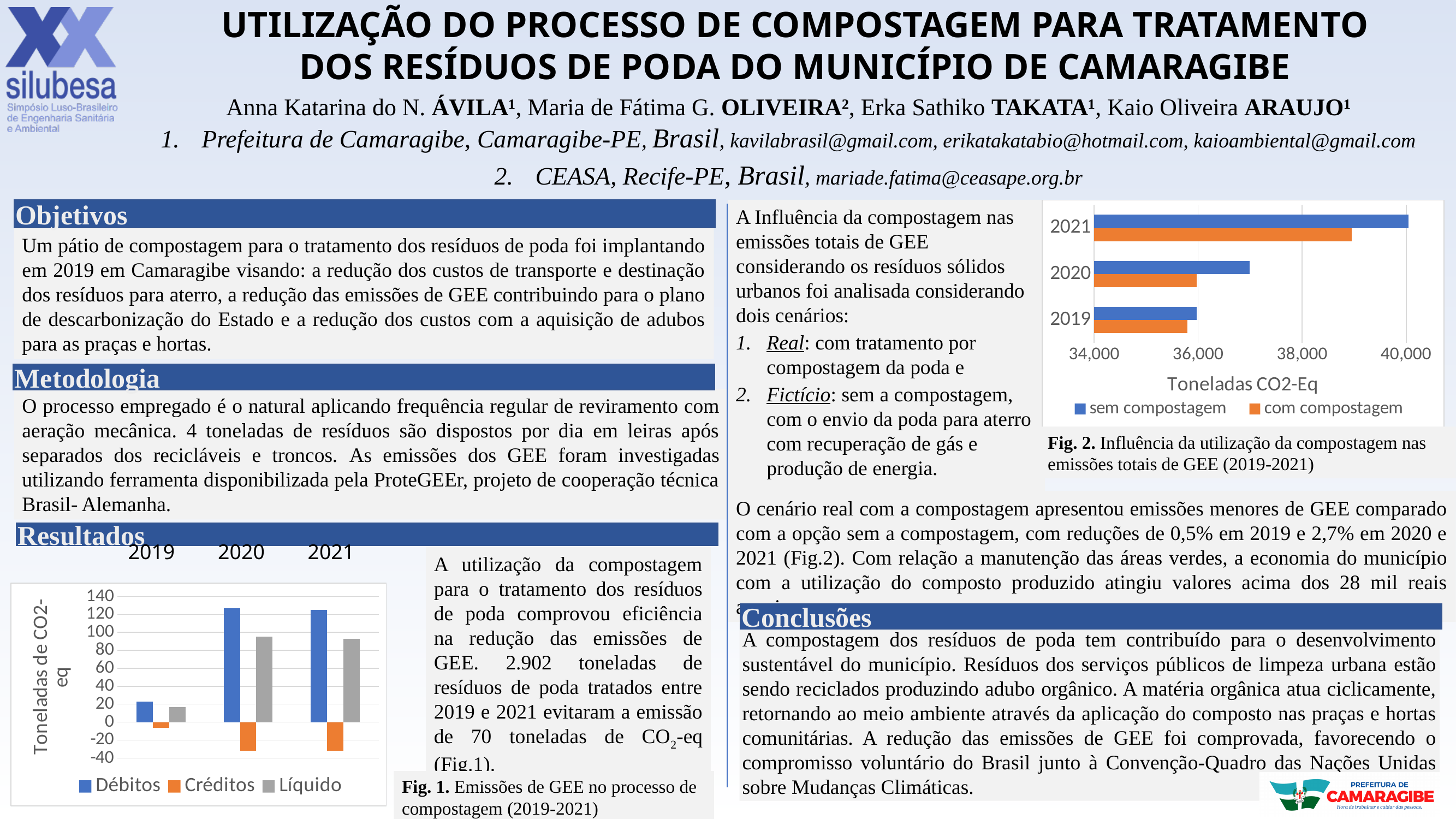
In Fig. 1 (bottom left), which is larger in 2020: Débitos or Líquido? Débitos What kind of chart is Fig. 1 (bottom left, Emissões de GEE no processo de compostagem)? bar chart In Fig. 2 (top right), which year has the highest 'sem compostagem' value? 2021 In Fig. 1 (bottom left), how many series does the legend list? 3 In Fig. 2 (top right), do the 'sem compostagem' values rise or fall from 2019 to 2021? rise In Fig. 2 (top right), how many series does the legend list? 2 What kind of chart is Fig. 2 (top right, Influência da utilização da compostagem nas emissões totais de GEE)? bar chart In Fig. 1 (bottom left), is the Débitos value for 2020 greater or less than 100? greater In Fig. 2 (top right), is the 'com compostagem' value for 2021 greater or less than 38,000? greater In Fig. 1 (bottom left), which year has the lowest Débitos value? 2019 In Fig. 1 (bottom left), is the Líquido value for 2019 greater or less than 40? less In Fig. 1 (bottom left), how many years are shown on the x axis? 3